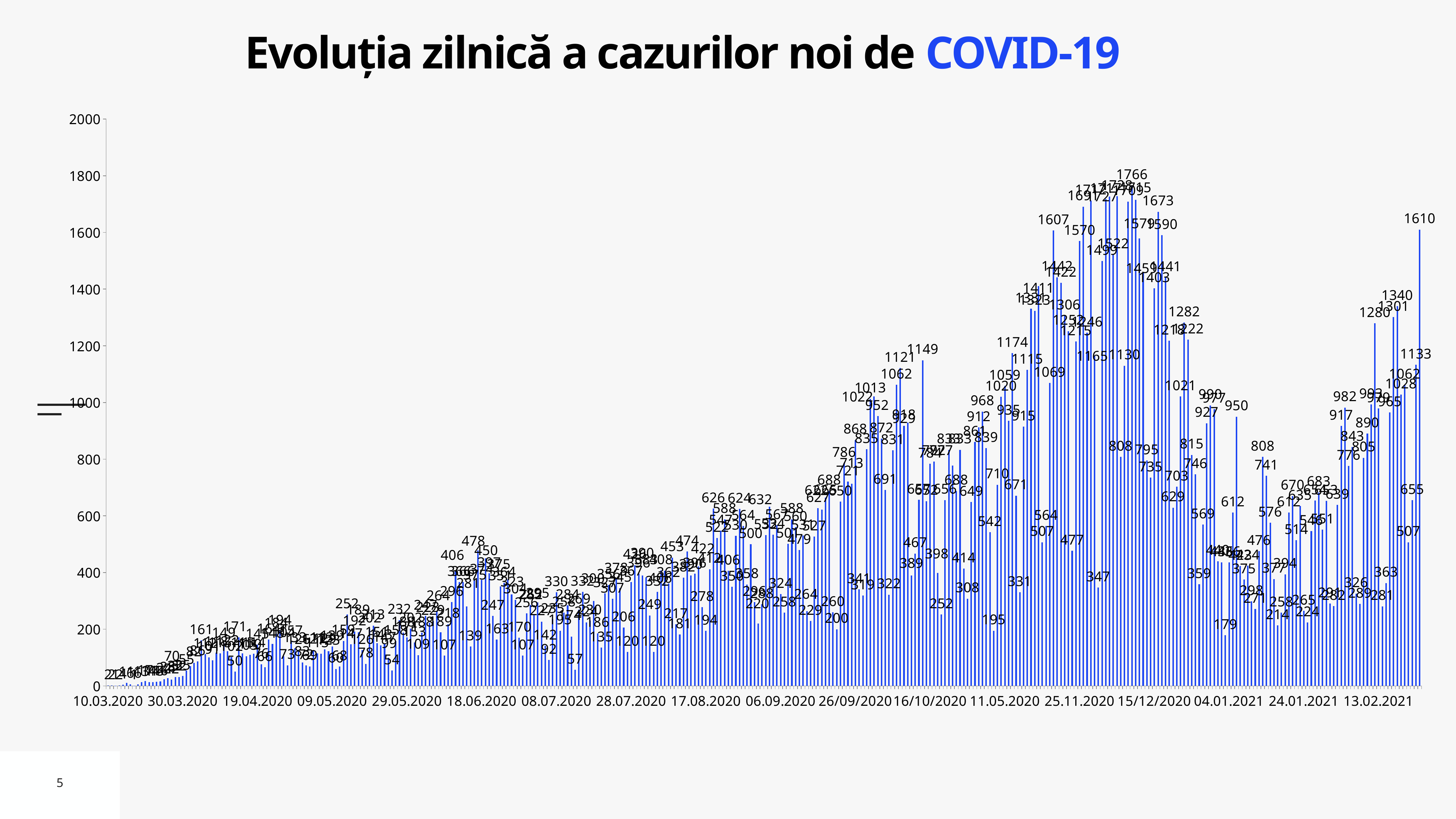
What is the title of the chart? Evoluția zilnică a cazurilor noi de COVID-19 Is the value of the first bar (10.03.2020) greater or less than 200? less What kind of chart is shown on the slide? bar chart What is the last date label on the x axis? 13.02.2021 What is the maximum value shown on the vertical axis? 2000 What is the value of the rightmost (last) bar on the chart? 1610 What is the highest daily value labelled on the chart? 1766 Is the value of the last bar on the chart greater or less than 1400? greater Which is larger: the peak value of 1766 or the last bar's value of 1610? 1766 Overall, do the daily values rise or fall from the start of the x axis (10.03.2020) to the end? rise What is the difference between the highest labelled value (1766) and the value of the last bar (1610)? 156 What is the first date label on the x axis? 10.03.2020